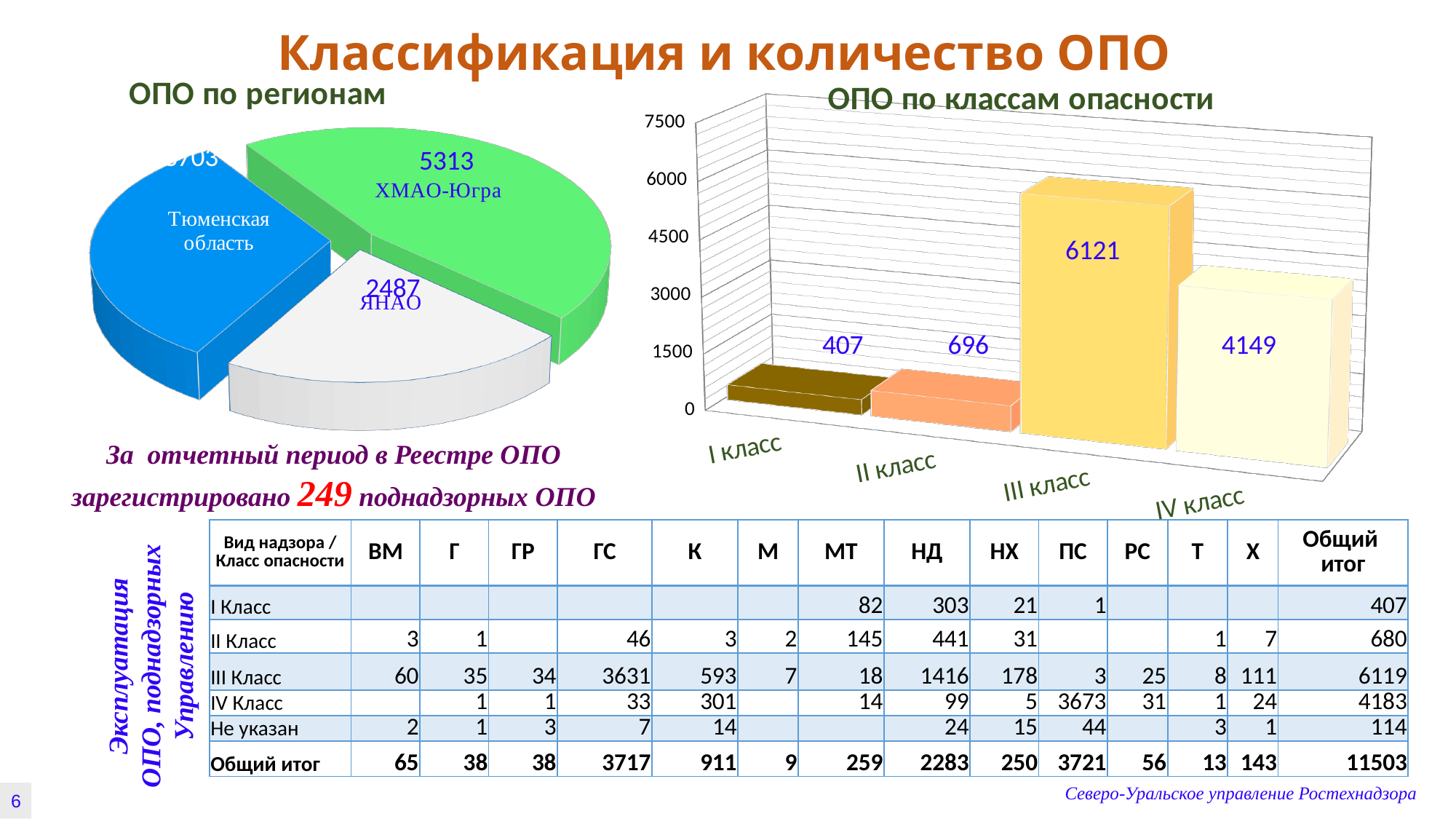
In the 'ОПО по регионам' pie chart, what is the value for ХМАО-Югра? 5313 In the 'ОПО по классам опасности' chart, what is the value for III класс? 6121 In the 'ОПО по классам опасности' chart, which is larger: the value for I класс or II класс? II класс What kind of chart is the 'ОПО по классам опасности' chart? bar chart What kind of chart is the 'ОПО по регионам' chart? pie chart In the 'ОПО по регионам' pie chart, which region has the largest slice? ХМАО-Югра In the 'ОПО по классам опасности' chart, what is the difference between the values for III класс and IV класс? 1972 In the 'ОПО по классам опасности' chart, which class has the lowest value? I класс In the 'ОПО по классам опасности' chart, what is the value for I класс? 407 In the 'ОПО по классам опасности' chart, which class has the highest value? III класс In the 'ОПО по классам опасности' chart, is the value for IV класс greater or less than 3000? greater How many bars are shown in the 'ОПО по классам опасности' chart? 4